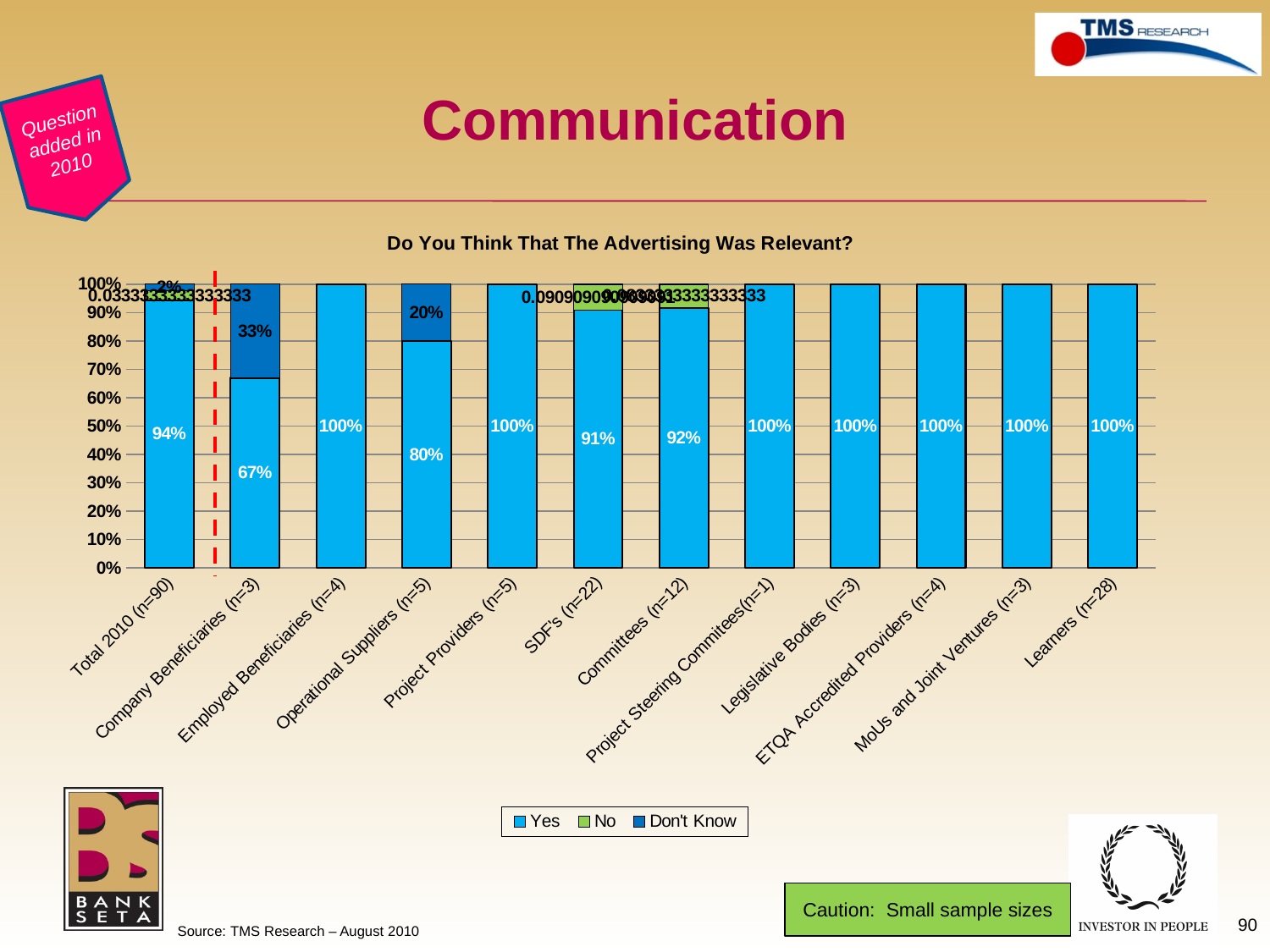
Which has a larger Yes value, Operational Suppliers (n=5) or Committees (n=12)? Committees (n=12) What is the Yes value for Company Beneficiaries (n=3)? 67% Which category has the lowest Yes value? Company Beneficiaries (n=3) What is the Yes value for SDF's (n=22)? 91% What is the title of the chart? Do You Think That The Advertising Was Relevant? How many categories are shown on the x axis? 12 What kind of chart is shown on the slide? Stacked bar chart What is the difference between the Yes value for Total 2010 (n=90) and the Yes value for Company Beneficiaries (n=3)? 27 percentage points What is the Don't Know value for Company Beneficiaries (n=3)? 33% What is the Yes value for Operational Suppliers (n=5)? 80% How many series does the legend list? 3 What is the Yes value for Total 2010 (n=90)? 94%